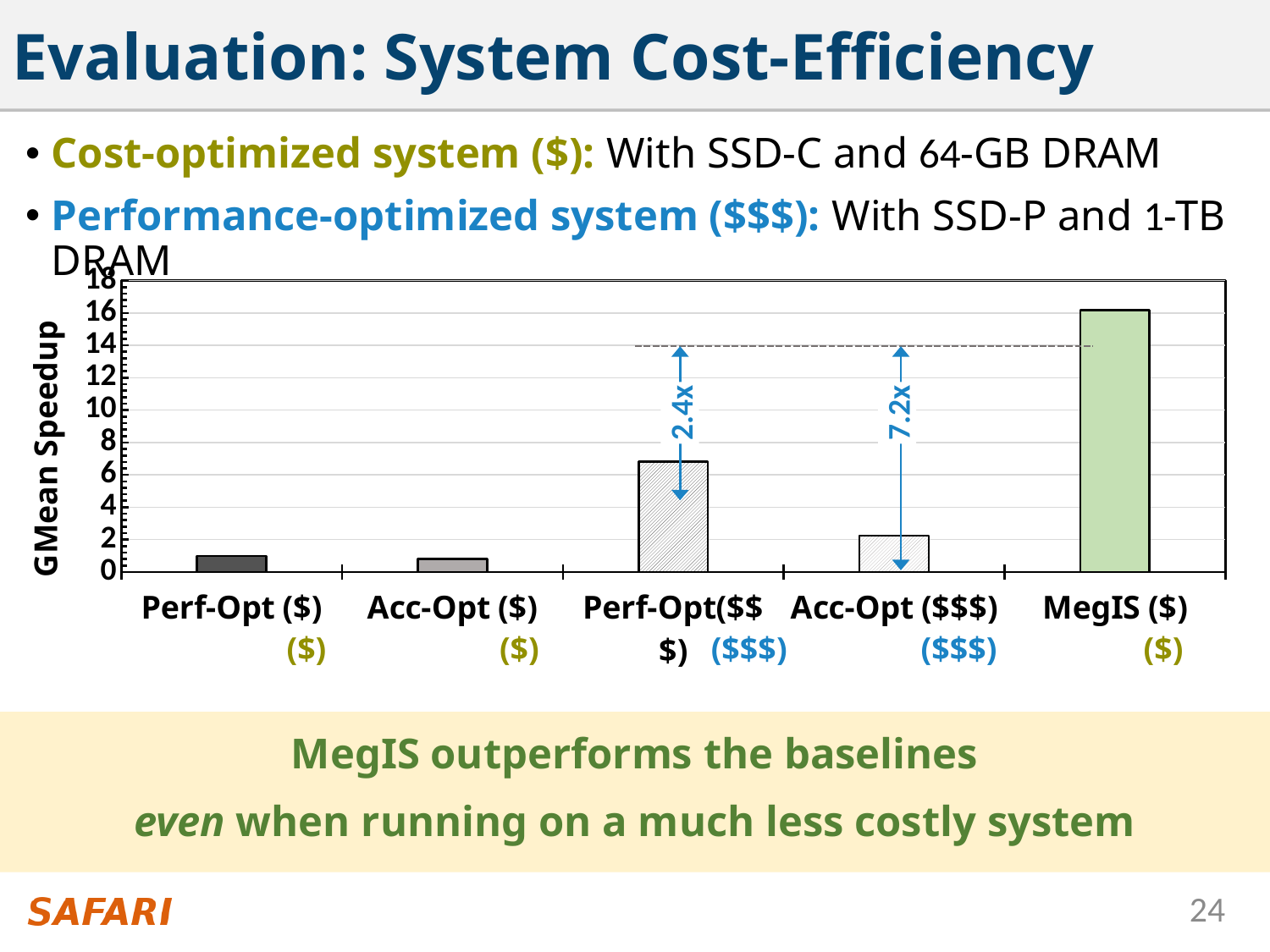
What speedup factor is annotated between Perf-Opt($$$) and MegIS ($) on the chart? 2.4x What is the label of the y axis of the chart? GMean Speedup Which category has the highest GMean Speedup? MegIS ($) Which has a higher GMean Speedup, MegIS ($) or Perf-Opt($$$)? MegIS ($) How many categories are plotted along the x axis of the chart? 5 Which has a higher GMean Speedup, Perf-Opt($$$) or Acc-Opt ($$$)? Perf-Opt($$$) Is the GMean Speedup for Perf-Opt ($) greater or less than 2? less What is the maximum value shown on the y axis of the chart? 18 Is the GMean Speedup for Acc-Opt ($$$) greater or less than 4? less What kind of chart is shown on the slide? bar chart Is the GMean Speedup for Perf-Opt($$$) greater or less than 8? less